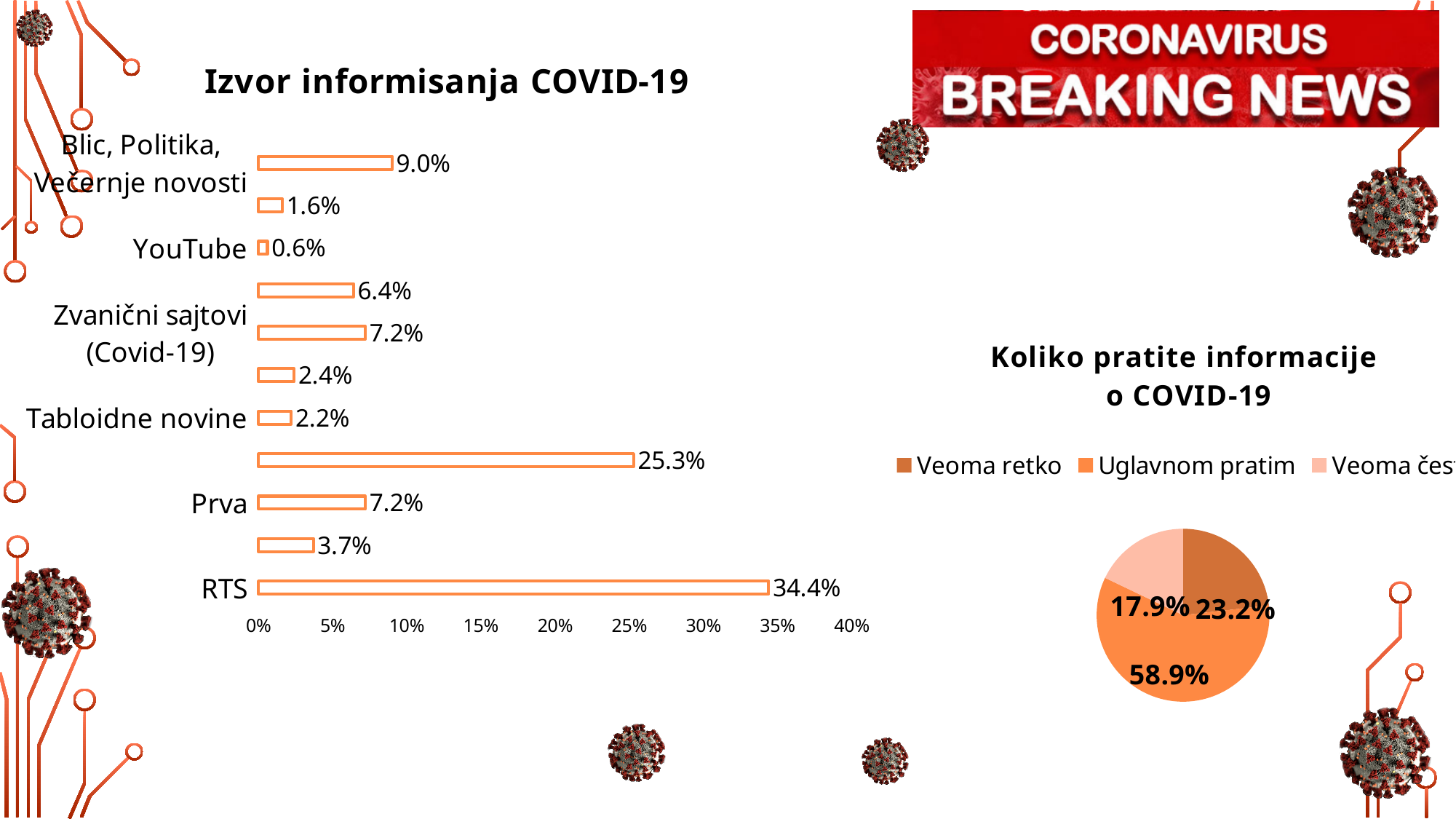
How many bars are plotted in the bar chart 'Izvor informisanja COVID-19'? 11 In the bar chart 'Izvor informisanja COVID-19', is the value for Blic, Politika, Večernje novosti greater or less than 10%? less In the bar chart 'Izvor informisanja COVID-19', which labelled category has the lowest value? YouTube What kind of chart is 'Izvor informisanja COVID-19'? bar chart In the bar chart 'Izvor informisanja COVID-19', what is the value for Tabloidne novine? 2.2% In the bar chart 'Izvor informisanja COVID-19', what is the difference between the value for RTS and the value for Blic, Politika, Večernje novosti? 25.4 percentage points In the bar chart 'Izvor informisanja COVID-19', what is the value for RTS? 34.4% In the pie chart 'Koliko pratite informacije o COVID-19', what share does 'Veoma retko' have? 23.2% In the pie chart 'Koliko pratite informacije o COVID-19', what share does 'Uglavnom pratim' have? 58.9% In the bar chart 'Izvor informisanja COVID-19', which is larger: the value for Prva or the value for Tabloidne novine? Prva In the bar chart 'Izvor informisanja COVID-19', which labelled category has the highest value? RTS In the bar chart 'Izvor informisanja COVID-19', what is the value for YouTube? 0.6%